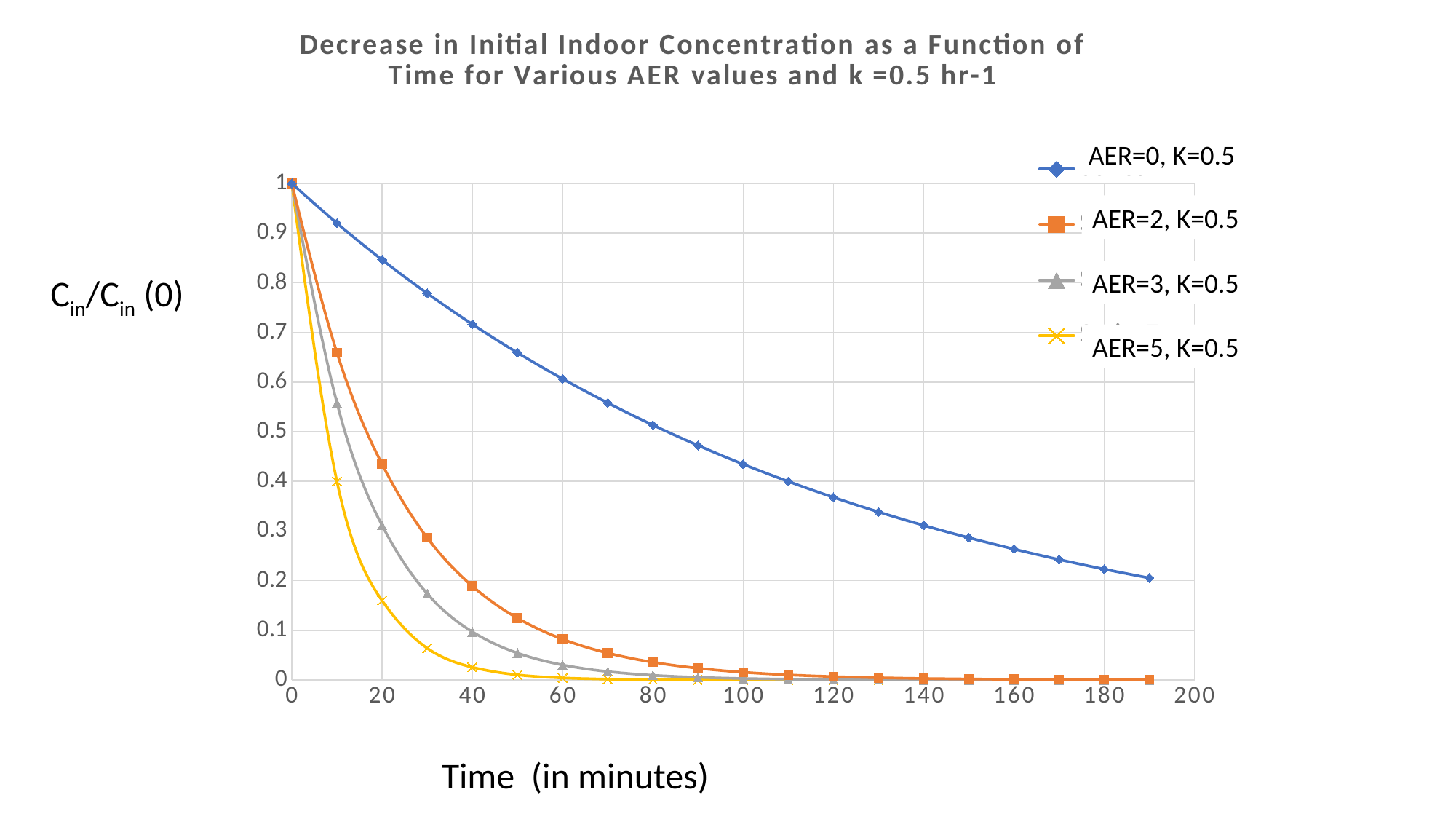
Is the value for AER=0, K=0.5 at 100 minutes greater or less than 0.4? greater Is the value for AER=3, K=0.5 at 10 minutes greater or less than 0.5? greater How many series does the legend list? 4 Do the values of the AER=0, K=0.5 series rise or fall as time increases? fall Which series has the lowest value at 20 minutes? AER=5, K=0.5 Is the value for AER=0, K=0.5 at 120 minutes greater or less than 0.4? less Which series has the highest value at 100 minutes? AER=0, K=0.5 What is the label of the x axis? Time (in minutes) At 60 minutes, which is larger: the value for AER=0, K=0.5 or the value for AER=2, K=0.5? AER=0, K=0.5 What is the value of the AER=0, K=0.5 series at time 0? 1 What kind of chart is shown on the slide? line chart